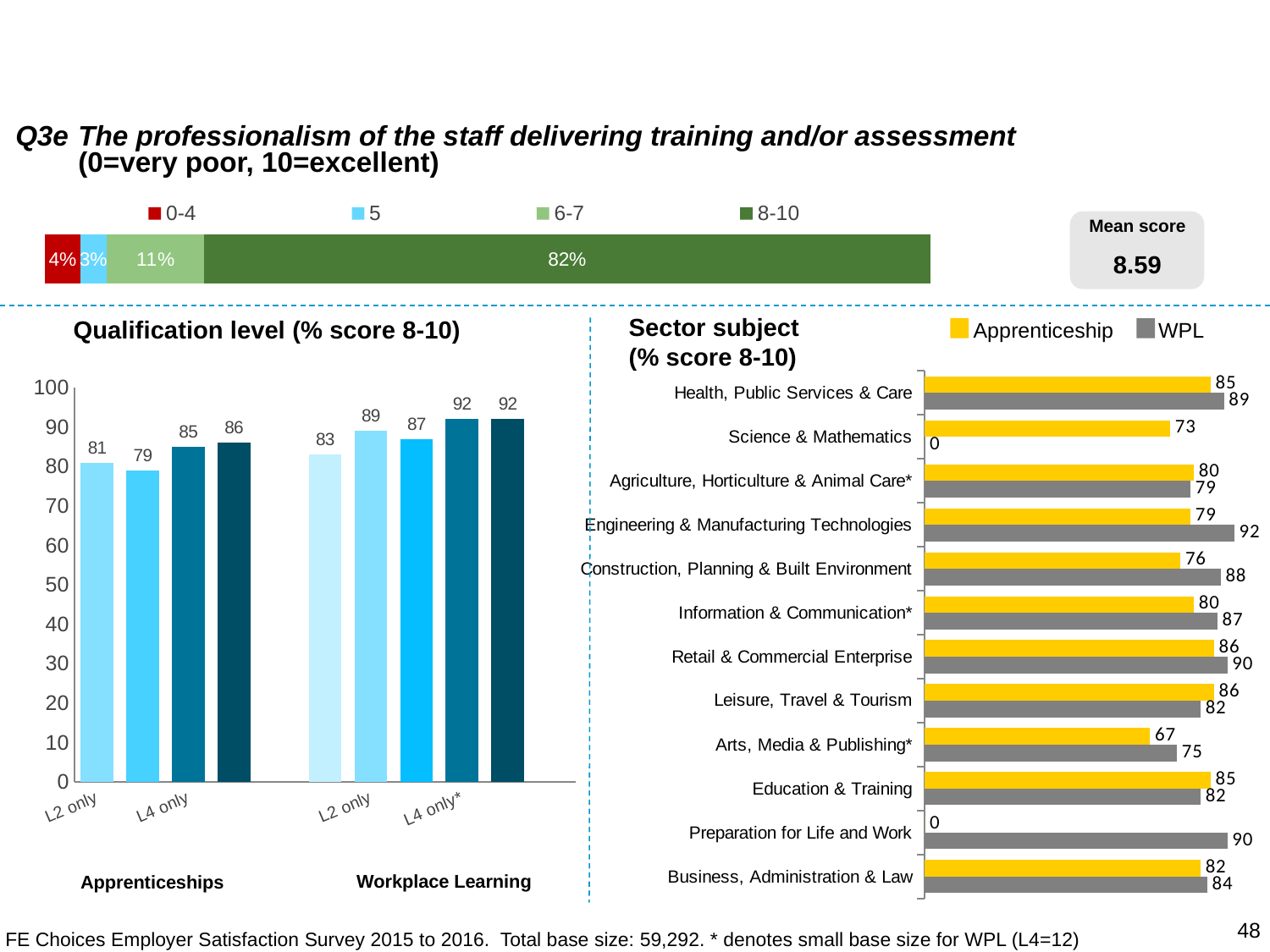
In the top stacked bar chart, what percentage of employers gave a score of 8-10? 82% How many series does the legend of the top stacked bar chart list? 4 In the Sector subject chart, what is the Apprenticeship value for Science & Mathematics? 73 In the Qualification level chart, what is the value for L2 only under Apprenticeships? 81 In the Qualification level chart, what is the value for L4 only under Apprenticeships? 85 What kind of chart is the Qualification level chart? bar chart In the Qualification level chart, what is the difference between L2 only and L4 only under Apprenticeships? 4 In the Sector subject chart, which sector has the lowest Apprenticeship value among those with a non-zero value? Arts, Media & Publishing* In the top stacked bar chart, what percentage gave a score of 6-7? 11% In the Sector subject chart, which is larger for Leisure, Travel & Tourism: Apprenticeship or WPL? Apprenticeship In the Sector subject chart, what is the WPL value for Engineering & Manufacturing Technologies? 92 How many sector subjects are listed in the Sector subject chart? 12